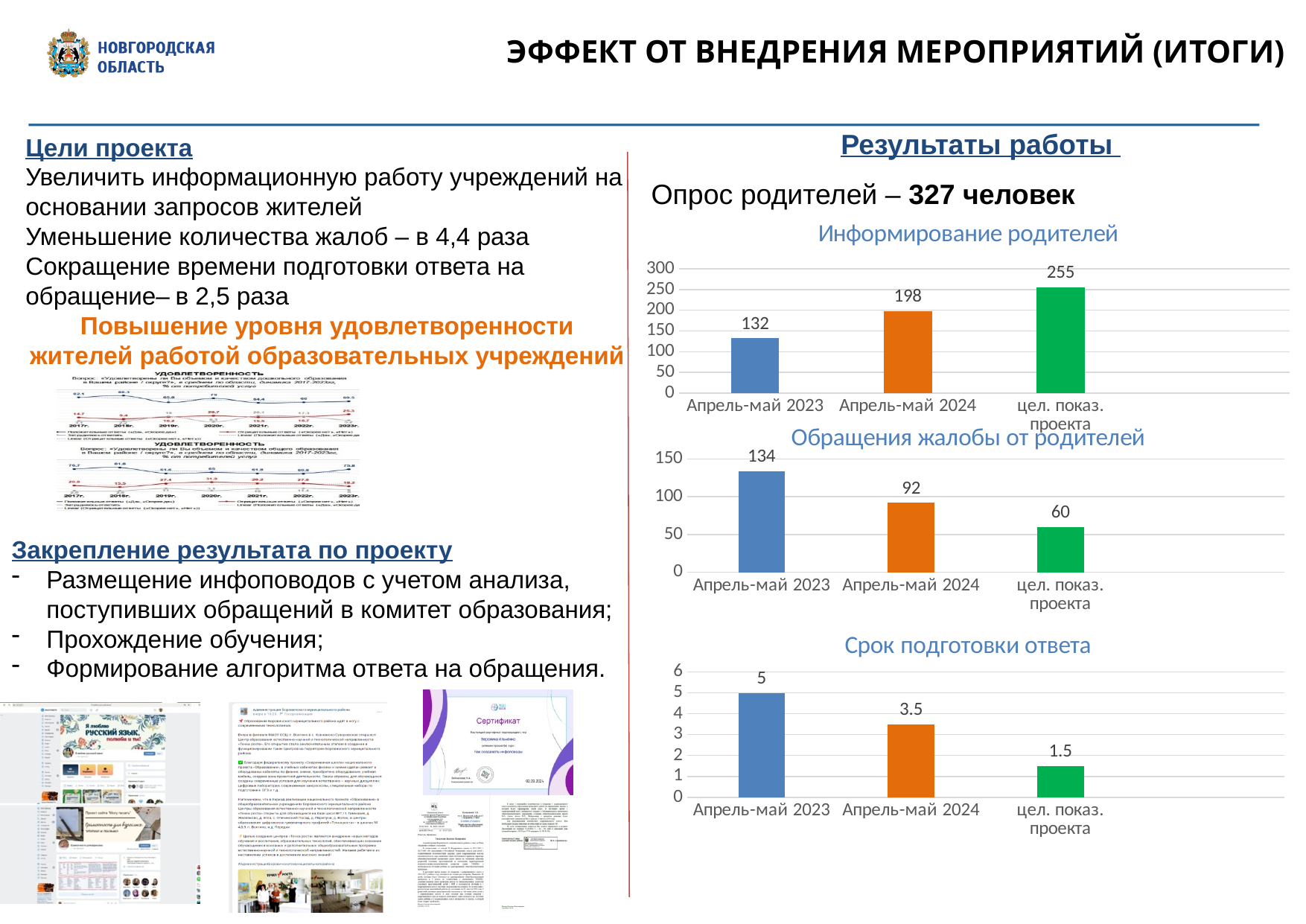
On the chart titled "Срок подготовки ответа", what is the value for Апрель-май 2024? 3.5 On the chart titled "Обращения жалобы от родителей", what is the difference between the values for Апрель-май 2023 and Апрель-май 2024? 42 How many categories are shown on the chart titled "Срок подготовки ответа"? 3 What kind of chart is the chart titled "Срок подготовки ответа"? bar chart On the chart titled "Обращения жалобы от родителей", what is the value for Апрель-май 2023? 134 On the chart titled "Информирование родителей", what is the difference between the value for цел. показ. проекта and the value for Апрель-май 2023? 123 On the chart titled "Обращения жалобы от родителей", is the value for Апрель-май 2024 greater or less than 100? less On the chart titled "Обращения жалобы от родителей", which category has the lowest value? цел. показ. проекта On the chart titled "Информирование родителей", what is the value for Апрель-май 2024? 198 On the chart titled "Информирование родителей", do the values rise or fall from left to right along the x axis? rise On the chart titled "Срок подготовки ответа", which is larger: the value for Апрель-май 2023 or the value for цел. показ. проекта? Апрель-май 2023 On the chart titled "Информирование родителей", which category has the highest value? цел. показ. проекта